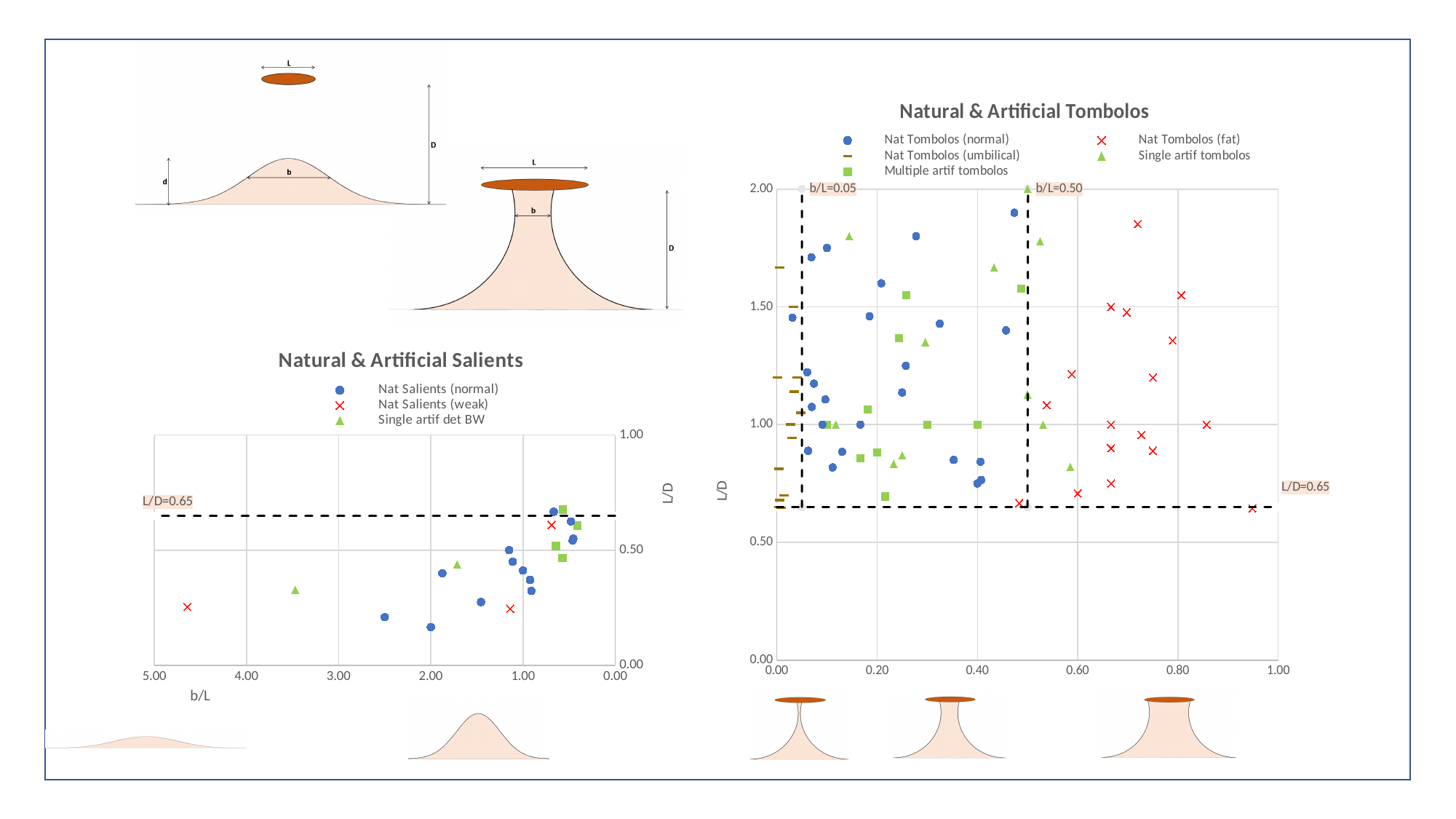
In the 'Natural & Artificial Salients' chart, is the L/D of the leftmost Nat Salients (weak) point greater or less than 0.50? less How many series does the legend of the 'Natural & Artificial Tombolos' chart list? 5 In the 'Natural & Artificial Salients' chart, is the L/D of the leftmost Single artif det BW point greater or less than 0.50? less What kind of chart is 'Natural & Artificial Salients'? scatter chart In the 'Natural & Artificial Tombolos' chart, is the L/D of the highest Nat Tombolos (normal) point greater or less than 1.50? greater In the 'Natural & Artificial Salients' chart, do the L/D values generally rise or fall as b/L decreases toward 0.00? rise What value does the horizontal dashed line in the 'Natural & Artificial Salients' chart mark? L/D=0.65 In the 'Natural & Artificial Salients' chart, how many Nat Salients (weak) points are plotted? 3 How many series does the legend of the 'Natural & Artificial Salients' chart list? 3 In the 'Natural & Artificial Tombolos' chart, which series is drawn with red X markers? Nat Tombolos (fat)